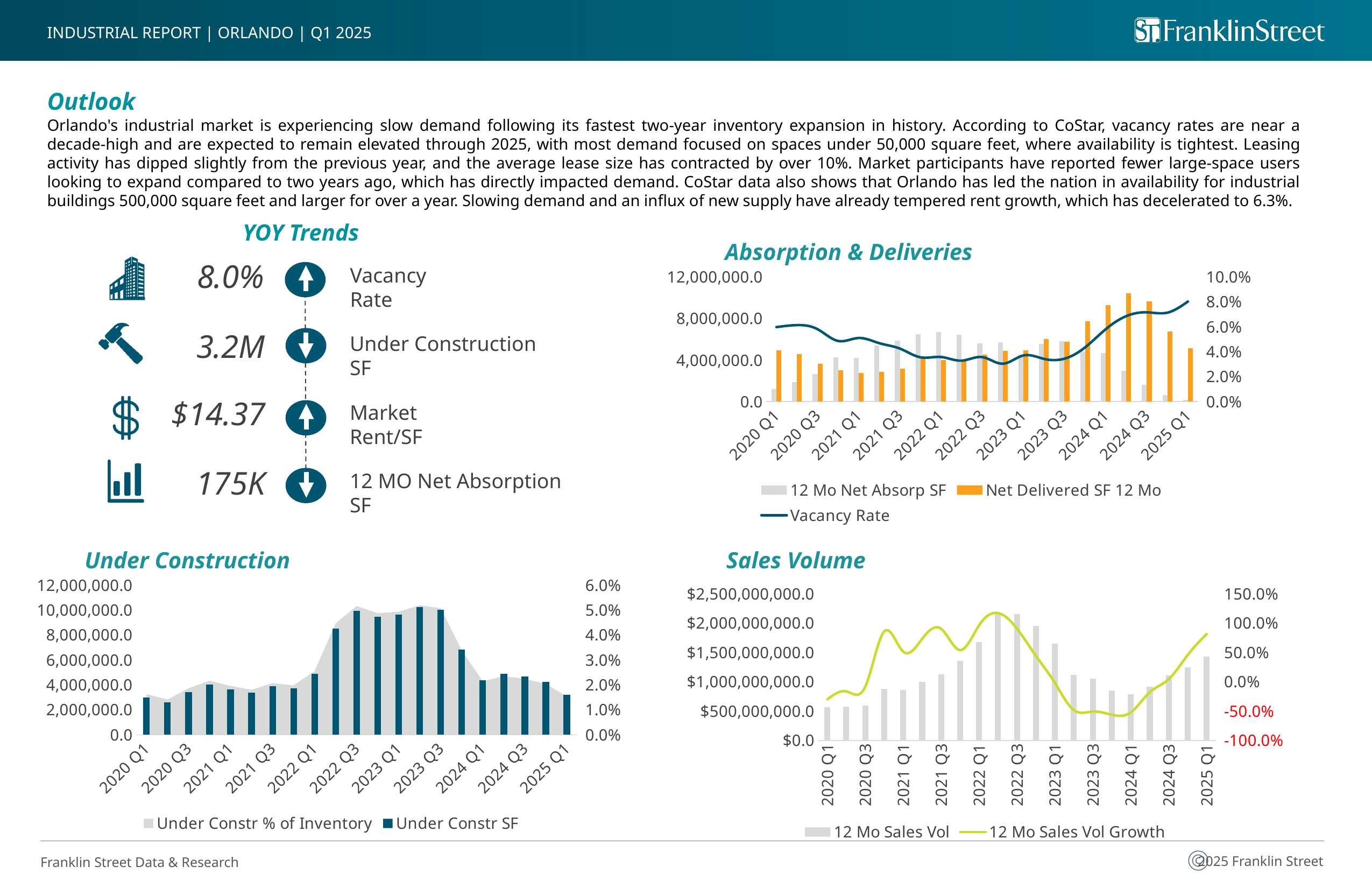
In the Absorption & Deliveries chart, is the Vacancy Rate for 2025 Q1 greater or less than 6.0%? greater In the Under Construction chart, does Under Constr SF rise or fall from 2023 Q3 to 2025 Q1? Fall In the Absorption & Deliveries chart, which quarter has the highest Net Delivered SF 12 Mo bar? 2024 Q2 How many series does the legend of the Under Construction chart list? 2 In the Absorption & Deliveries chart, what colour are the Net Delivered SF 12 Mo bars? Orange In the Sales Volume chart, is the 12 Mo Sales Vol Growth value for 2023 Q3 greater or less than 0.0%? less In the Absorption & Deliveries chart, is the 12 Mo Net Absorp SF value for 2025 Q1 greater or less than 4,000,000.0? less How many series does the legend of the Absorption & Deliveries chart list? 3